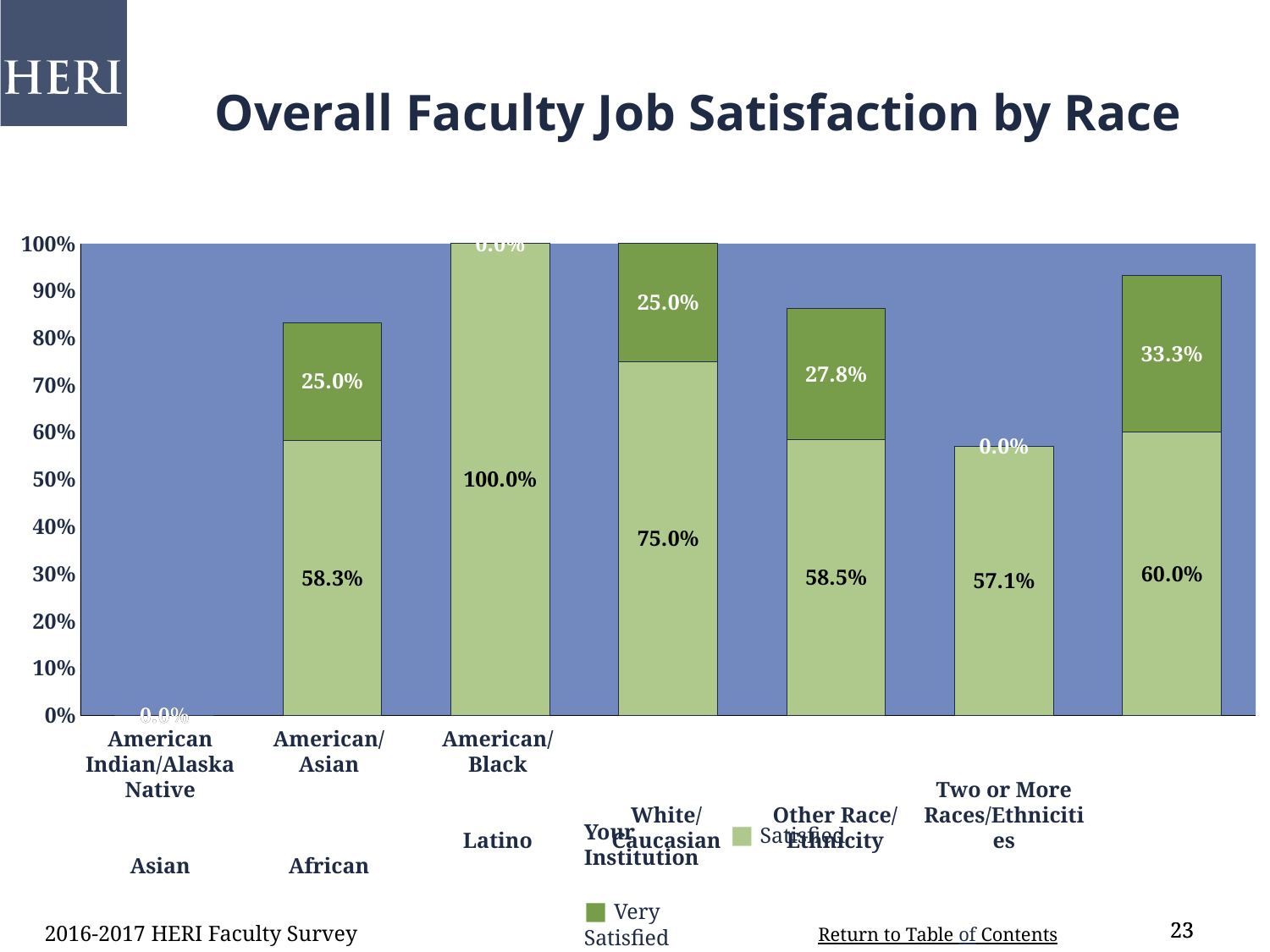
What is the Satisfied value for Two or More Races/Ethnicities? 60.0% What is the Satisfied value for Other Race/Ethnicity? 57.1% Which category has the highest Very Satisfied value? Two or More Races/Ethnicities Which has the larger Very Satisfied value, Latino or White/Caucasian? White/Caucasian How many race/ethnicity categories are plotted on the x axis? 7 What are the two legend entries? Satisfied and Very Satisfied How many series does the legend list? 2 What is the difference between the Satisfied values for White/Caucasian and Other Race/Ethnicity? 1.4 percentage points What is the Satisfied value for Latino faculty? 75.0% What is the Very Satisfied value for White/Caucasian faculty? 27.8% What kind of chart is shown on the slide? Stacked bar chart What is the combined total of Satisfied and Very Satisfied for Two or More Races/Ethnicities? 93.3%